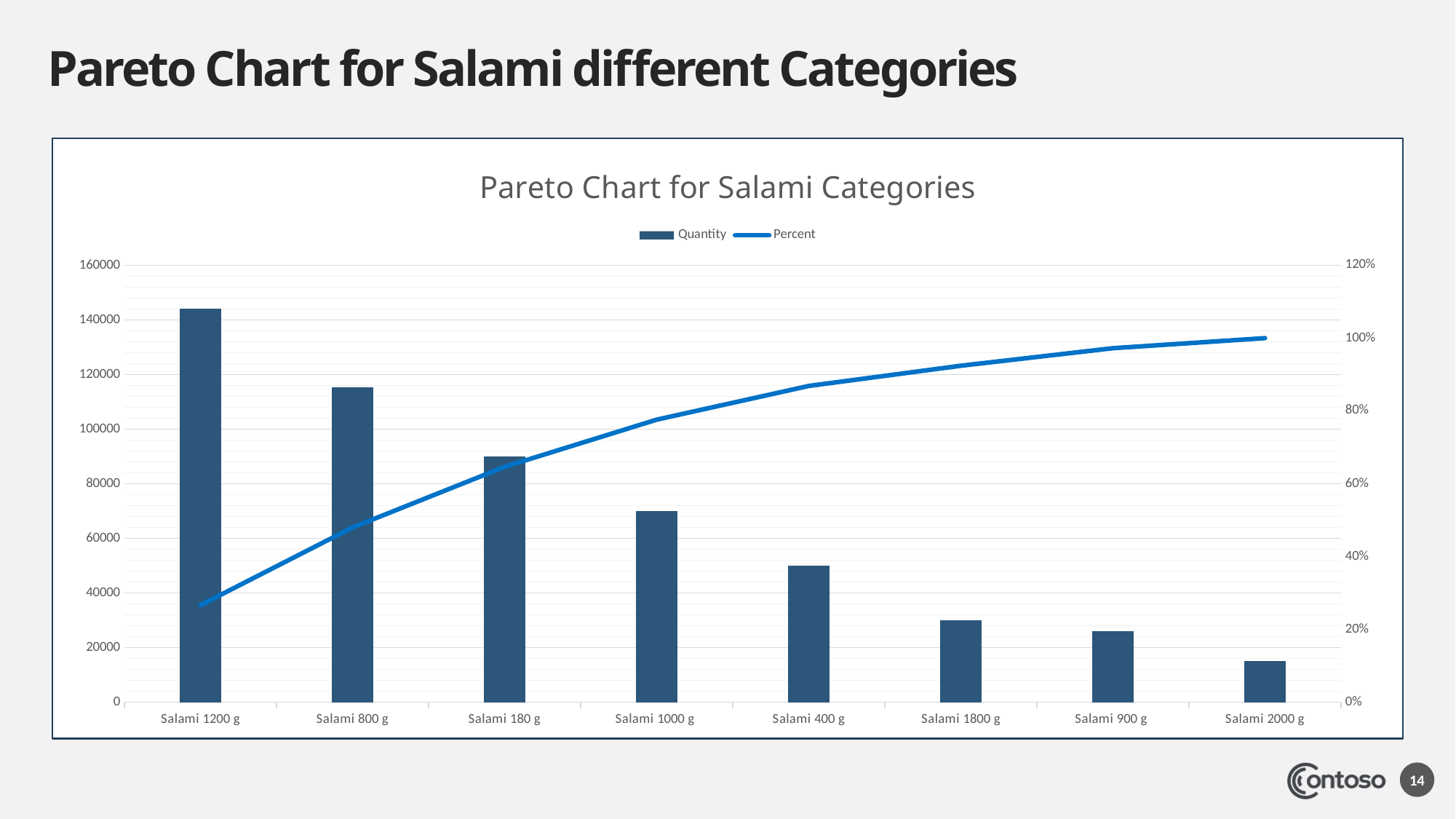
What are the two entries in the chart legend? Quantity and Percent What is the Percent value at Salami 2000 g? 100% Is the Quantity for Salami 400 g greater or less than 60000? less What kind of chart is shown on the slide? A bar chart combined with a line Is the Quantity for Salami 1200 g greater or less than 120000? greater Which has the larger Quantity, Salami 800 g or Salami 180 g? Salami 800 g Do the Quantity bars rise or fall from left to right along the x axis? fall Which category has the highest Quantity bar? Salami 1200 g Which category has the lowest Quantity bar? Salami 2000 g Is the Quantity for Salami 2000 g greater or less than 20000? less How many series does the legend list? 2 How many salami categories are shown on the x axis? 8